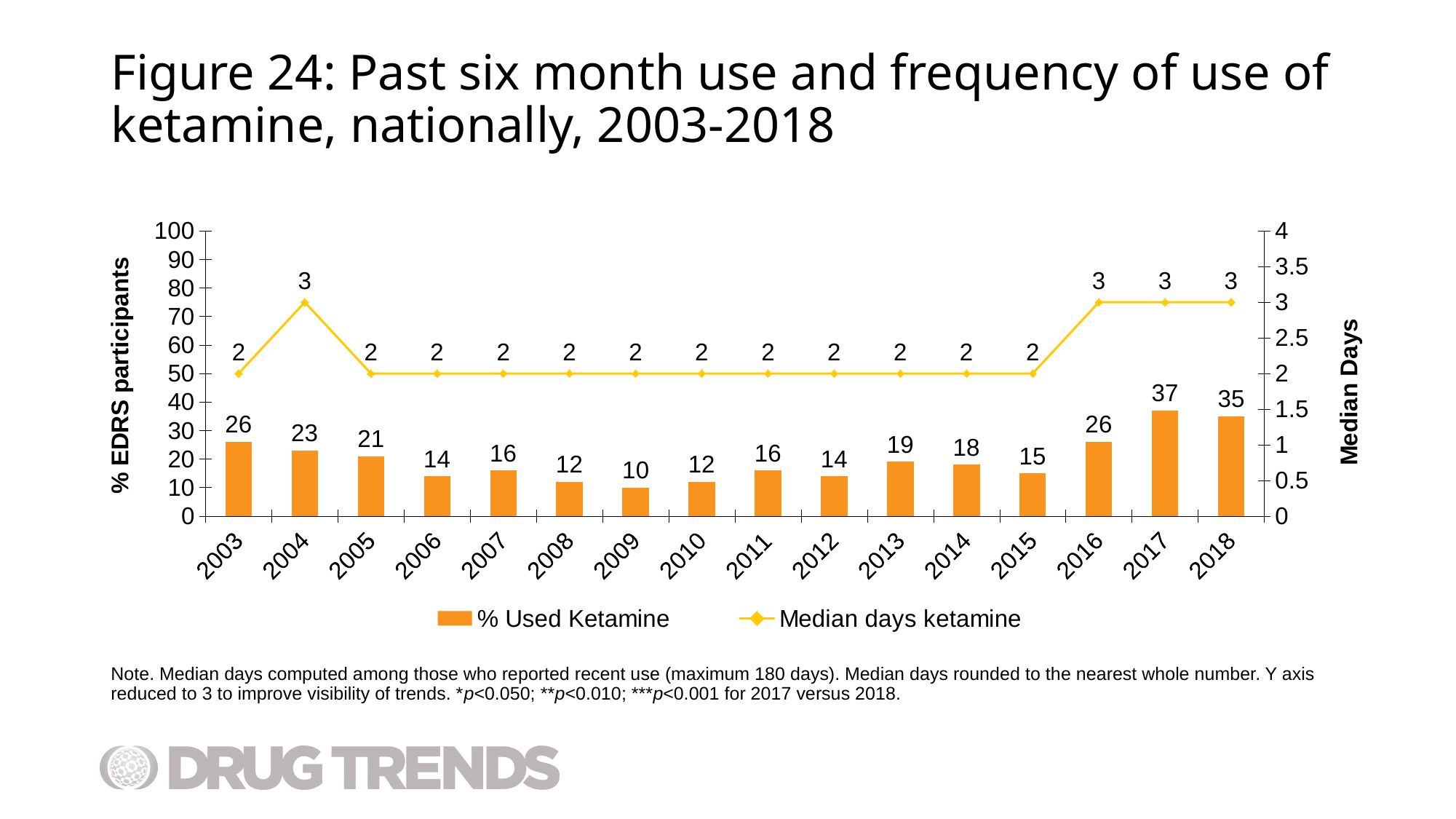
What kind of chart is used for the % Used Ketamine series? Bar chart How many series does the legend list? 2 Which year has a larger % Used Ketamine, 2003 or 2016? They are equal (26) What is the value of % Used Ketamine in 2017? 37 Does the % Used Ketamine value rise or fall from 2015 to 2017? Rise What is the difference between % Used Ketamine in 2017 and 2018? 2 How many years are shown on the x axis? 16 What is the label of the right-hand y axis? Median Days Which year has the lowest % Used Ketamine? 2009 Is the % Used Ketamine value for 2018 greater or less than 30? greater Which year has the highest % Used Ketamine? 2017 What is the Median days ketamine value in 2004? 3